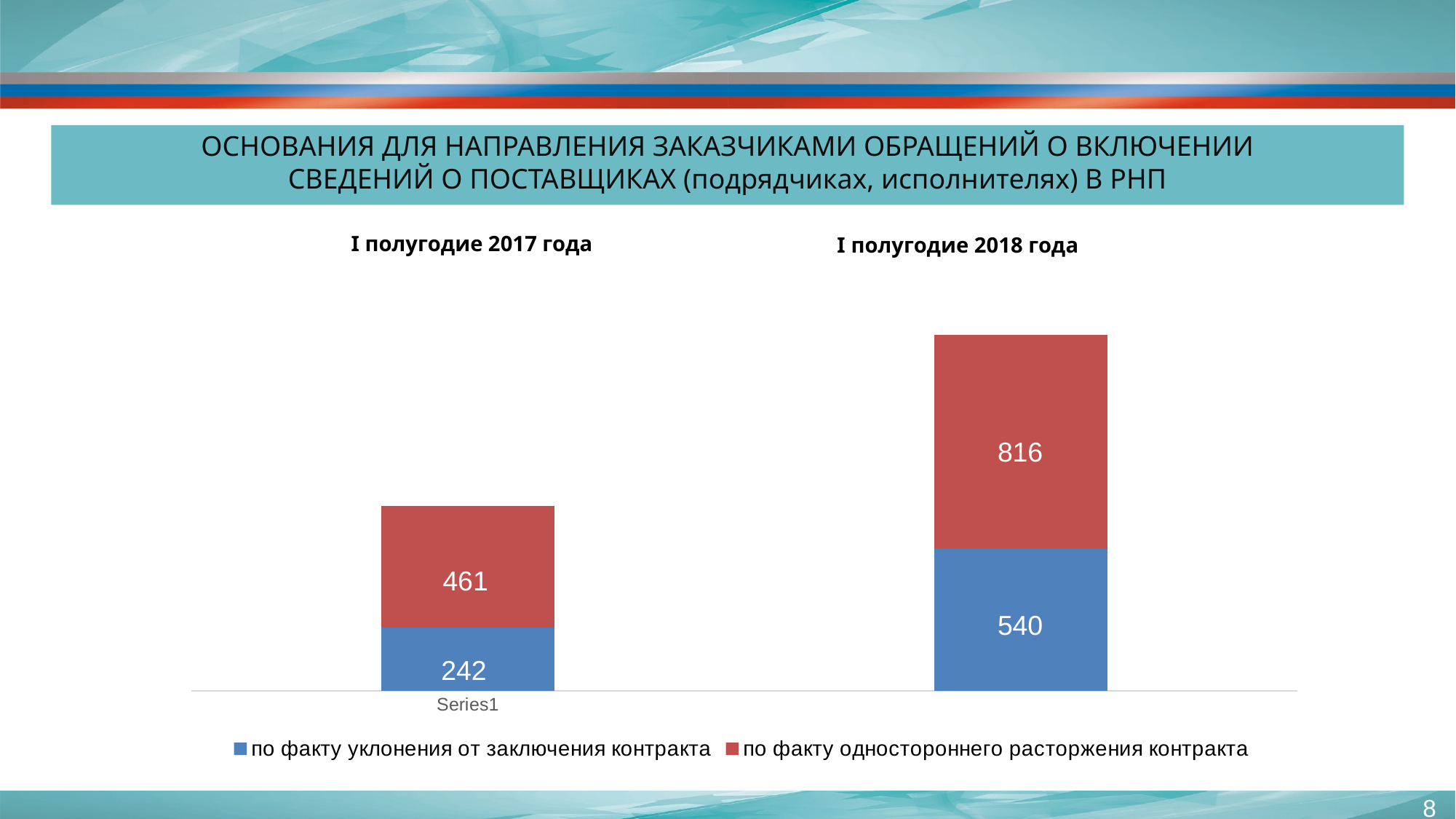
How many series does the legend list? 2 What is the total of the stacked bar for I полугодие 2018 года? 1356 What is the total of the stacked bar for I полугодие 2017 года? 703 What is the difference between the 'по факту уклонения от заключения контракта' values for I полугодие 2018 года and I полугодие 2017 года? 298 Which is larger in I полугодие 2018 года: 'по факту уклонения от заключения контракта' or 'по факту одностороннего расторжения контракта'? по факту одностороннего расторжения контракта What is the value for 'по факту уклонения от заключения контракта' in I полугодие 2017 года? 242 What kind of chart is shown on the slide? Stacked bar chart What is the value for 'по факту уклонения от заключения контракта' in I полугодие 2018 года? 540 What is the difference between the 'по факту одностороннего расторжения контракта' values for I полугодие 2018 года and I полугодие 2017 года? 355 Which period has the higher total stacked bar? I полугодие 2018 года What is the value for 'по факту одностороннего расторжения контракта' in I полугодие 2017 года? 461 What is the value for 'по факту одностороннего расторжения контракта' in I полугодие 2018 года? 816